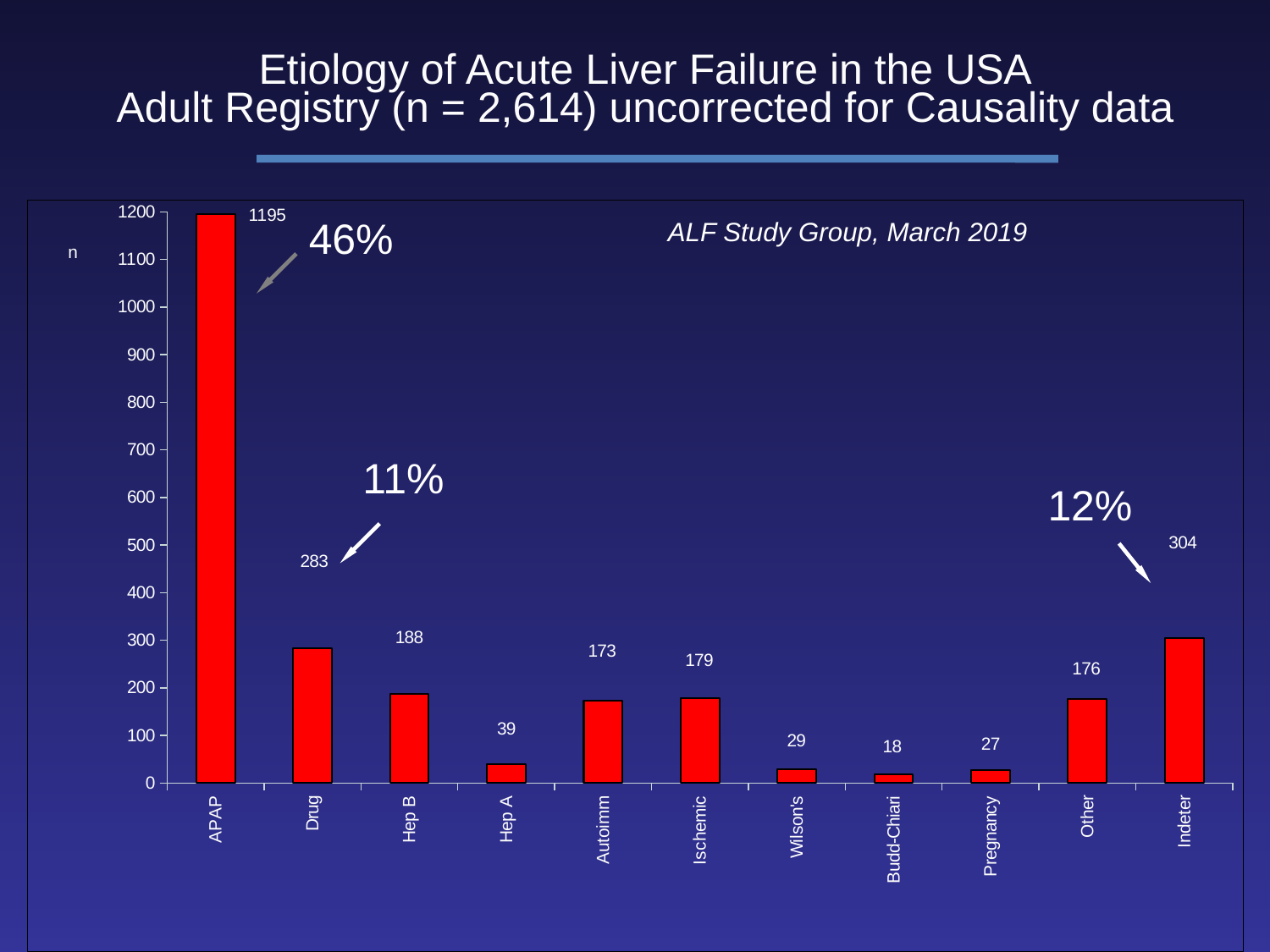
What kind of chart is shown on the slide? bar chart What is the value for APAP? 1195 Which category has the highest value? APAP What is the difference between the values for Autoimm and Ischemic? 6 What is the value for Indeter? 304 How many categories are shown on the x axis? 11 What is the difference between the values for APAP and Indeter? 891 What is the value for Drug? 283 Which category has the lowest value? Budd-Chiari Which is larger, the value for Hep B or the value for Ischemic? Hep B What percentage is annotated next to the Drug bar? 11% What is the value for Budd-Chiari? 18